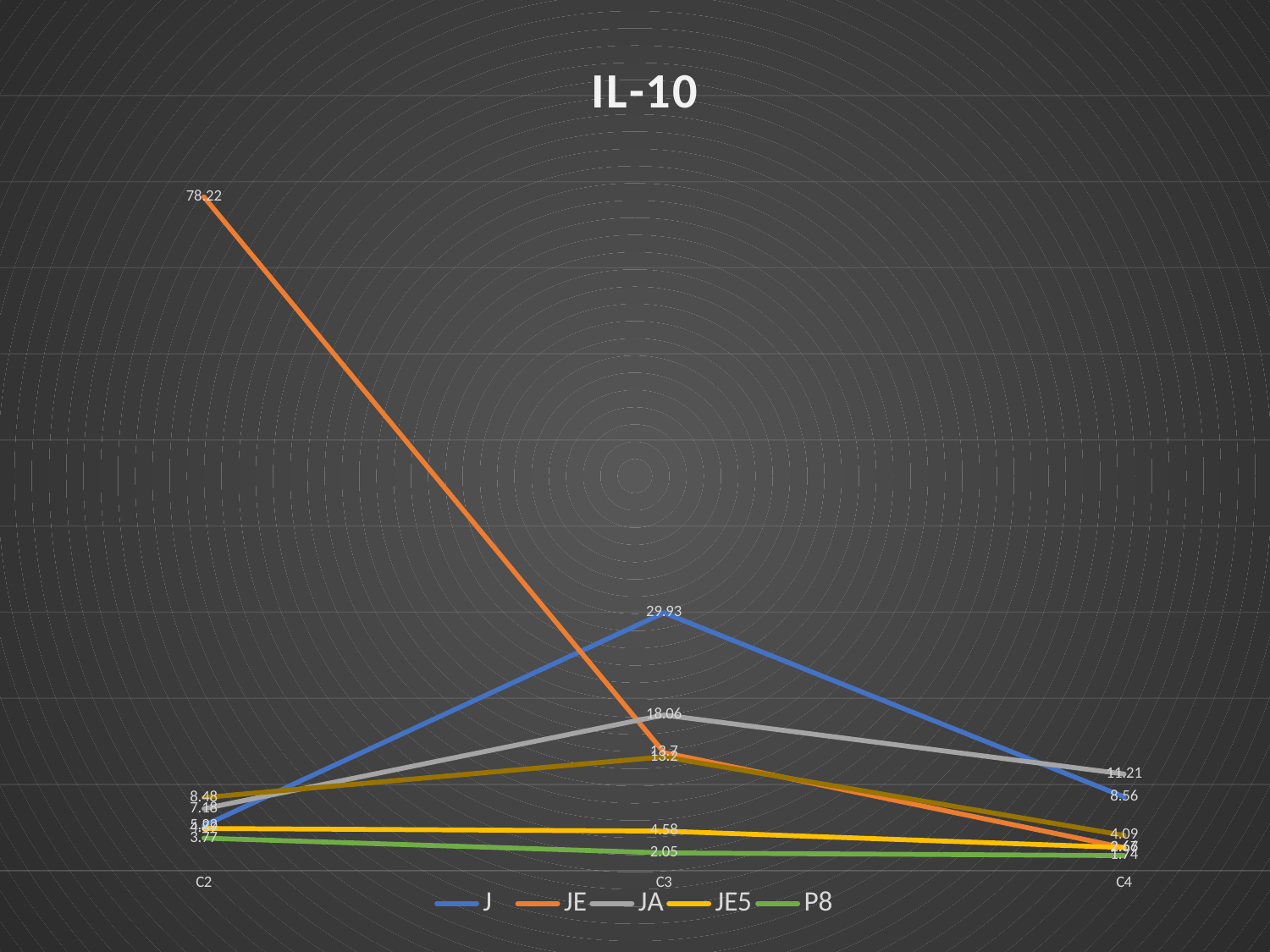
Does the JE series rise or fall from C2 to C4? Fall What is the difference between the J values at C3 and C4? 21.37 Which series has the lowest value at C4? P8 What is the value for J at C4? 8.56 What is the value for JA at C4? 11.21 What is the title of the chart? IL-10 What is the value for J at C3? 29.93 Which series has the highest value at C2? JE How many categories are shown on the x axis? 3 How many series does the legend list? 5 What is the value for JE at C2? 78.22 What type of chart is shown on the slide? Line chart